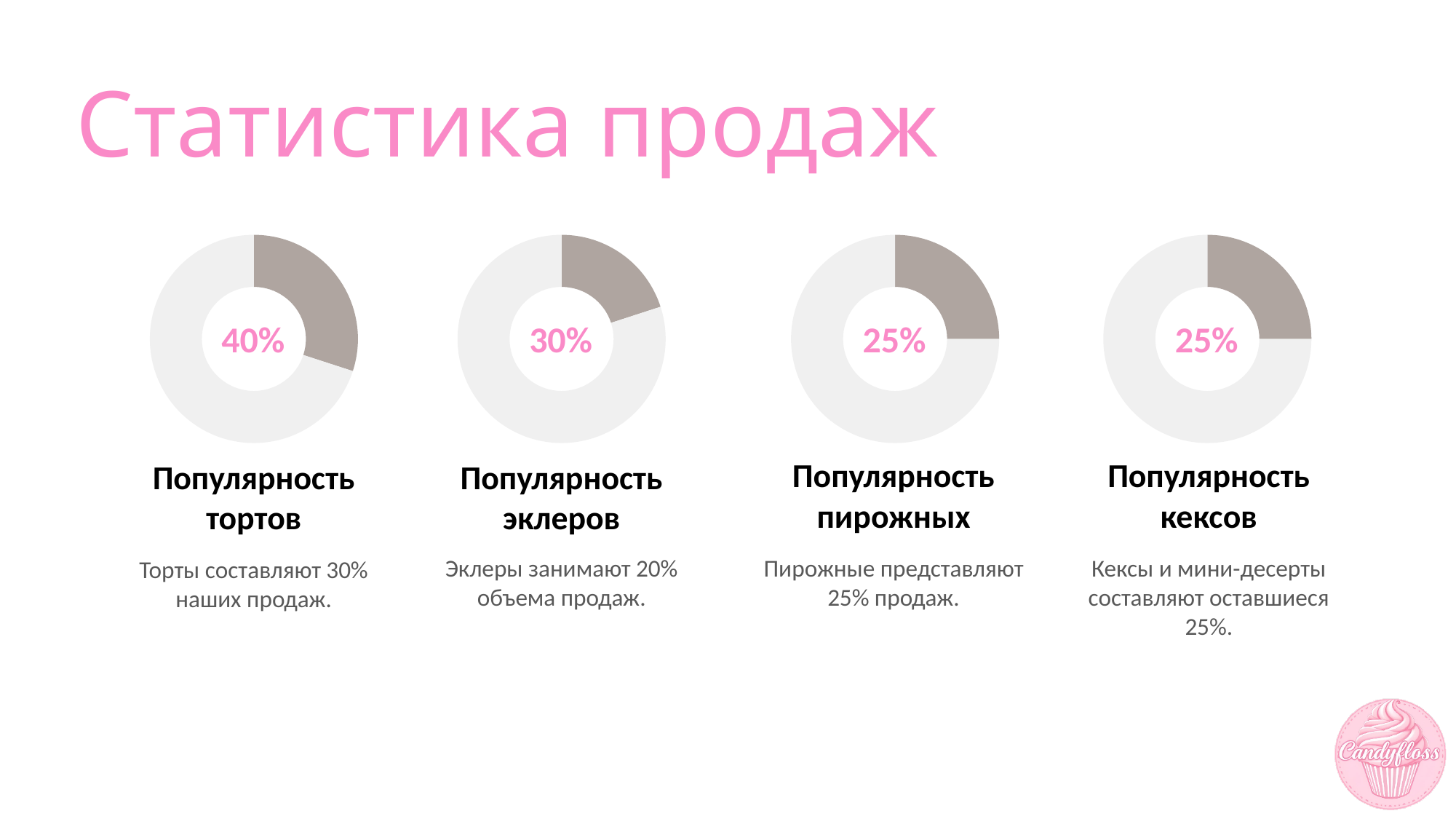
What value is shown in the centre of the "Популярность эклеров" donut chart? 30% What value is shown in the centre of the "Популярность кексов" donut chart? 25% How many donut charts are on the slide? 4 What is the difference between the percentage in the "Популярность эклеров" chart and the percentage in the "Популярность кексов" chart? 5% Which of the four donut charts shows the highest percentage? Популярность тортов What is the title of the slide containing the four donut charts? Статистика продаж Do the "Популярность пирожных" and "Популярность кексов" charts show the same percentage? Yes What value is shown in the centre of the "Популярность пирожных" donut chart? 25% Which shows a larger percentage: the "Популярность тортов" chart or the "Популярность пирожных" chart? Популярность тортов What kind of chart is used for "Популярность кексов"? Donut (pie) chart What is the difference between the percentage in the "Популярность тортов" chart and the percentage in the "Популярность эклеров" chart? 10% What value is shown in the centre of the "Популярность тортов" donut chart? 40%